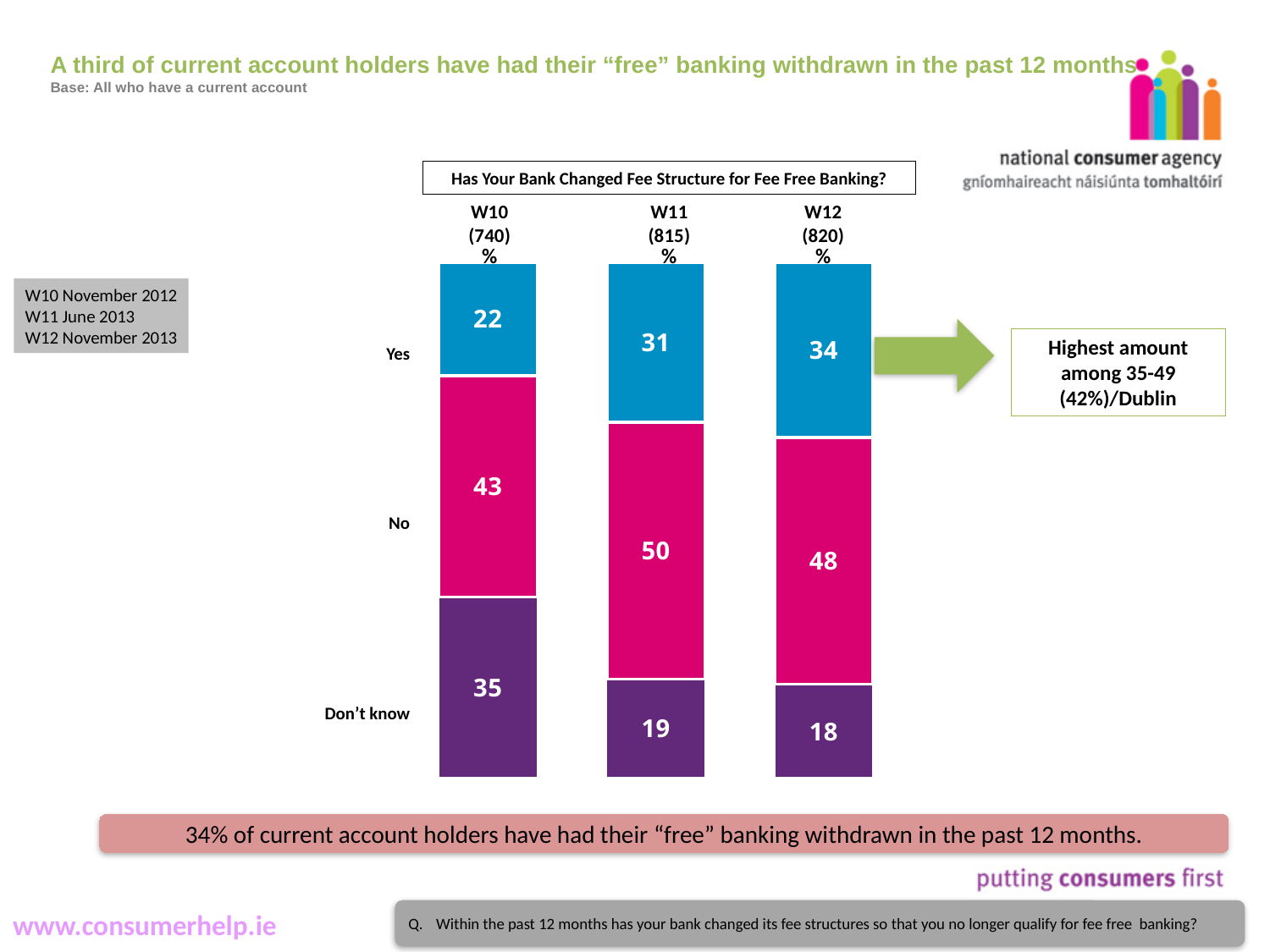
How many response categories are stacked in each bar? 3 What percentage answered "Don't know" in W10? 35 How many waves (bars) are shown in the chart? 3 In which wave is the "Don't know" percentage lowest? W12 Does the "Yes" percentage rise or fall from W10 to W12? Rise What is the title of the chart? Has Your Bank Changed Fee Structure for Fee Free Banking? What percentage answered "No" in W11? 50 What percentage answered "Yes" in W12? 34 What kind of chart is shown on the slide? Stacked bar chart What is the difference between the "Yes" percentage in W12 and in W10? 12 Which is larger: the "No" percentage in W10 or in W12? W12 In which wave is the "Yes" percentage highest? W12